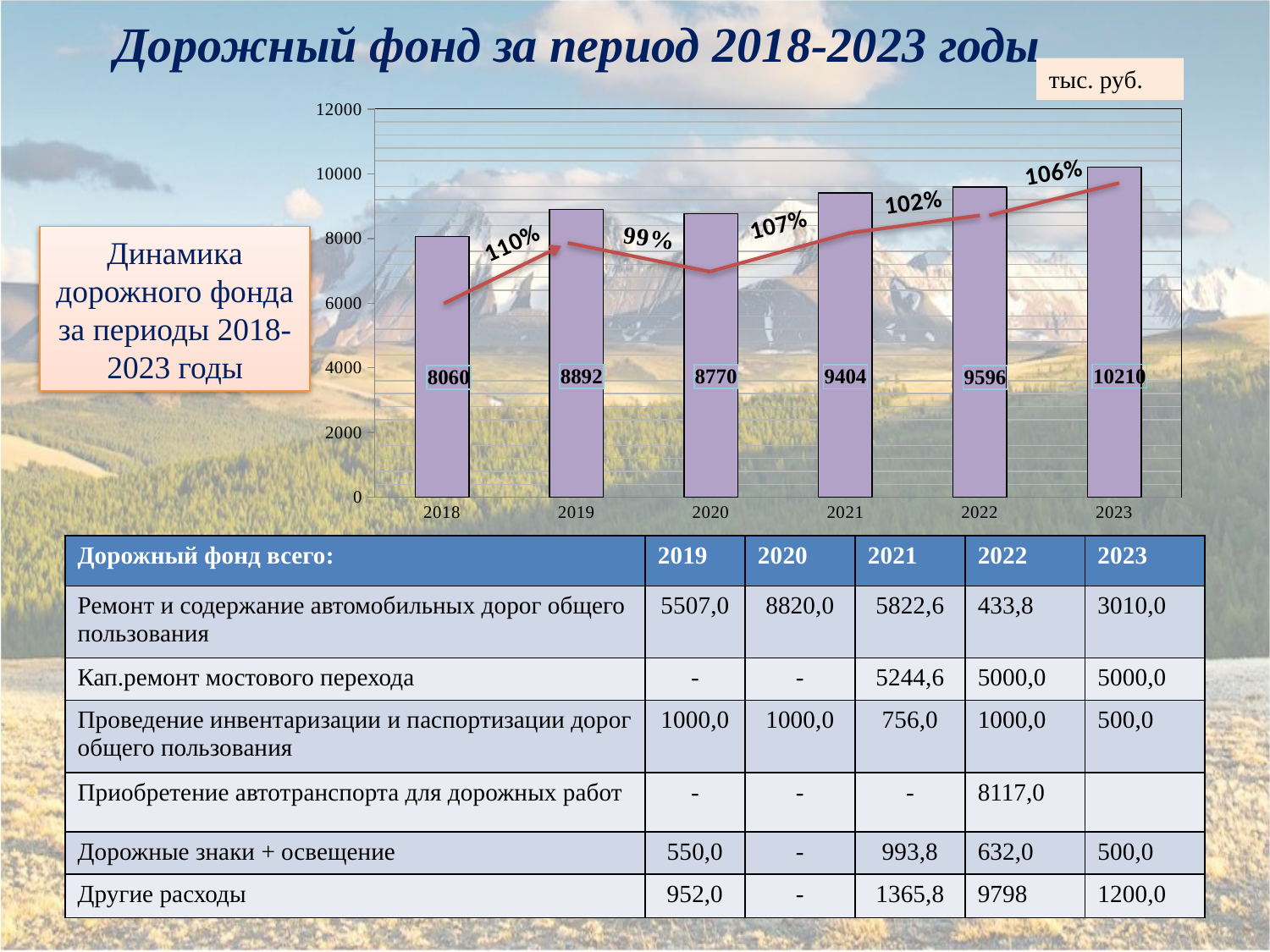
Is the road fund value for 2022 greater or less than 10000 on the chart? less What kind of chart is shown on the slide? Bar chart with a line What is the value of the road fund for 2023 on the chart? 10210 What is the value of the road fund for 2018 on the chart? 8060 What is the difference between the road fund values for 2023 and 2022 on the chart? 614 Which year has the highest road fund value on the chart? 2023 What is the value of the road fund for 2021 on the chart? 9404 Which year has the larger road fund value on the chart, 2019 or 2020? 2019 What percentage label is shown on the line for 2020 on the chart? 99% How many years are shown on the x axis of the chart? 6 Which year has the lowest road fund value on the chart? 2018 What unit of measurement is indicated for the chart values? тыс. руб.